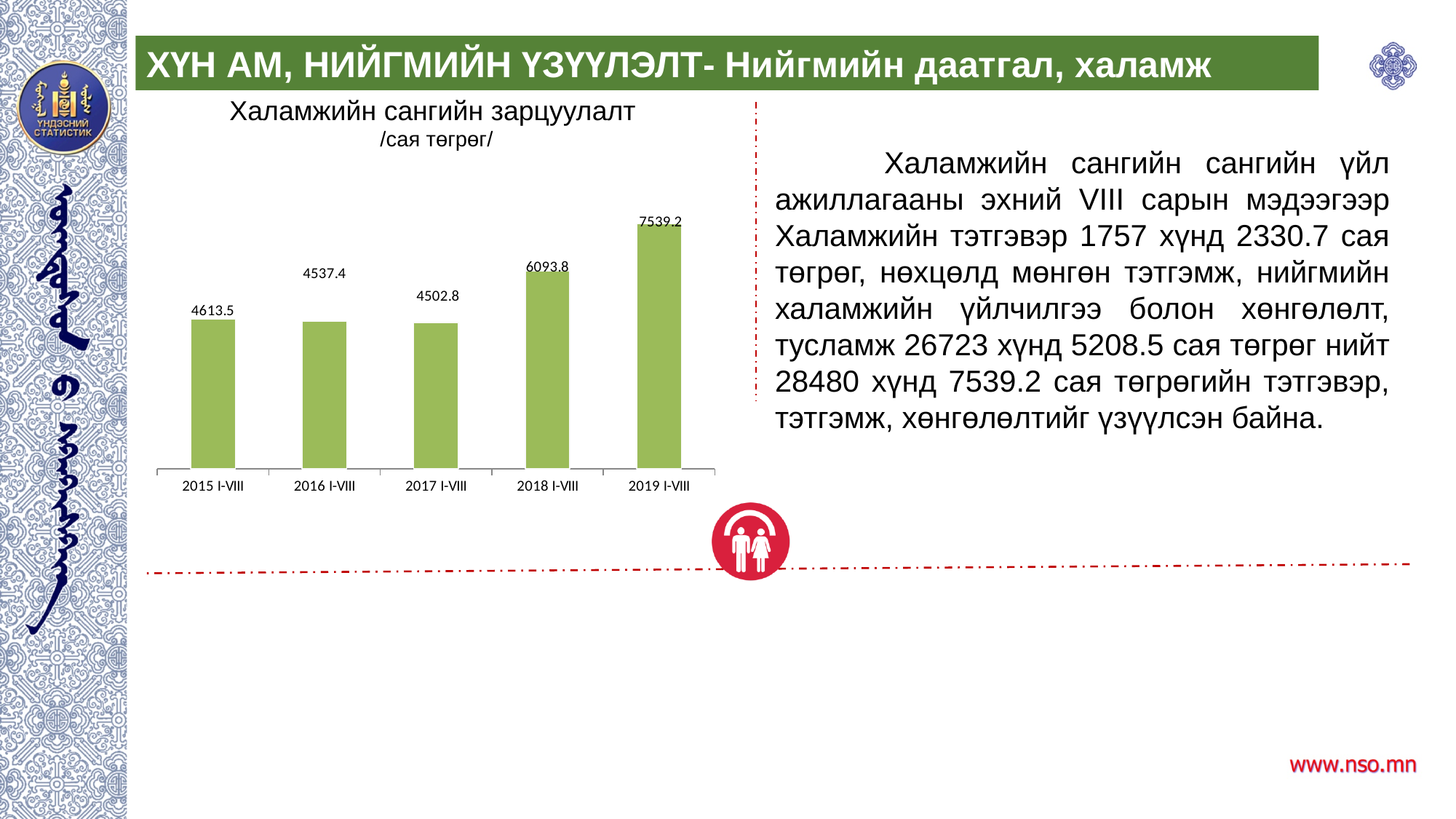
What is the value for 2015 I-VIII in the chart? 4613.5 Which period has the highest value in the chart? 2019 I-VIII What is the difference between the values for 2018 I-VIII and 2017 I-VIII? 1591.0 What is the difference between the values for 2019 I-VIII and 2018 I-VIII? 1445.4 What is the value for 2017 I-VIII in the chart? 4502.8 Which is larger, the value for 2018 I-VIII or the value for 2017 I-VIII? 2018 I-VIII Do the values rise or fall from 2017 I-VIII to 2019 I-VIII? rise What kind of chart is shown on the slide? bar chart What is the value for 2016 I-VIII in the chart? 4537.4 How many periods are shown on the x axis of the chart? 5 What is the value for 2018 I-VIII in the chart? 6093.8 What is the value for 2019 I-VIII in the chart? 7539.2